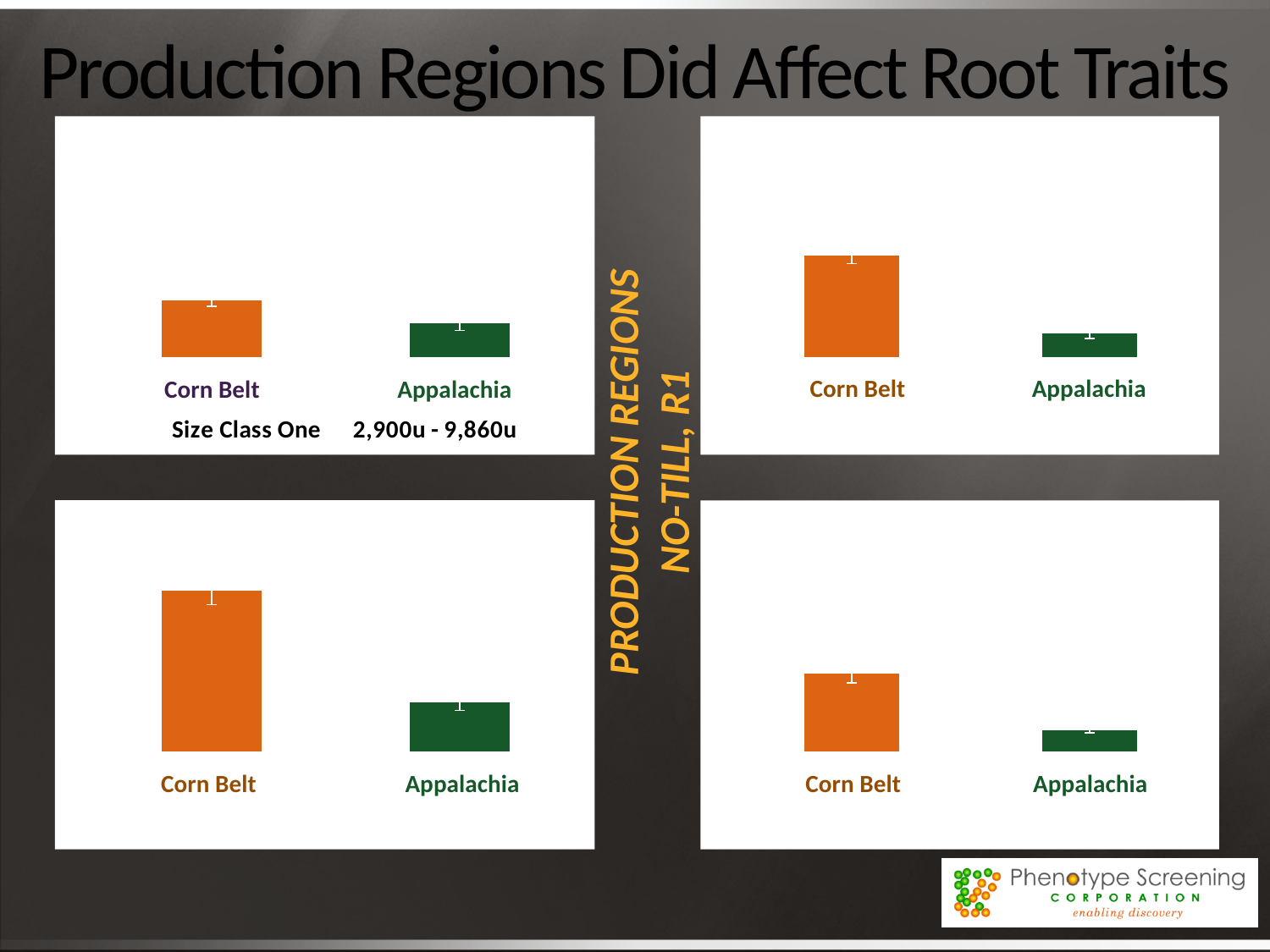
How many bar charts are shown on the slide? 4 In the top-right chart, which category has the highest bar? Corn Belt In the top-right chart, which category has the lowest bar? Appalachia In the top-left chart, which category has the taller bar, Corn Belt or Appalachia? Corn Belt What size class and range is labelled beneath the top-left chart? Size Class One 2,900u - 9,860u In the bottom-left chart, which category has the highest bar? Corn Belt What kind of chart is the top-left chart? bar chart What are the two categories shown on the x axis of the top-right chart? Corn Belt and Appalachia How many categories are shown in the bottom-right chart? 2 In the bottom-right chart, is the bar for Appalachia taller or shorter than the bar for Corn Belt? shorter In the bottom-left chart, which category has the lowest bar? Appalachia